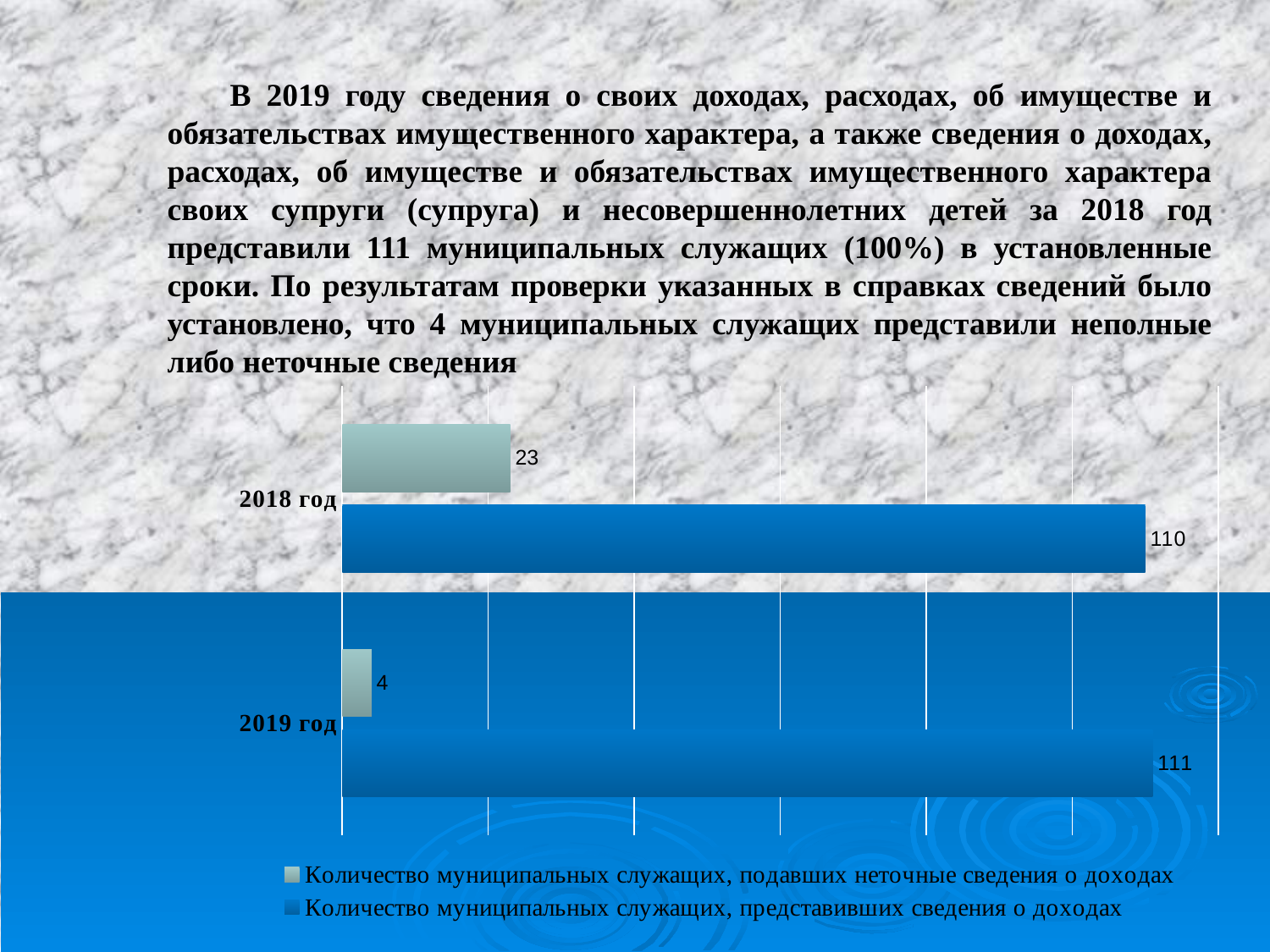
What is the value for 'Количество муниципальных служащих, подавших неточные сведения о доходах' in 2019 год? 4 How many categories (years) does the chart show? 2 Which series is shown in dark blue in the legend? Количество муниципальных служащих, представивших сведения о доходах What is the value for 'Количество муниципальных служащих, представивших сведения о доходах' in 2018 год? 110 Which year has the higher value for 'Количество муниципальных служащих, подавших неточные сведения о доходах'? 2018 год Which year has the lower value for 'Количество муниципальных служащих, представивших сведения о доходах'? 2018 год What is the difference between the 2018 and 2019 values for 'Количество муниципальных служащих, подавших неточные сведения о доходах'? 19 What is the value for 'Количество муниципальных служащих, подавших неточные сведения о доходах' in 2018 год? 23 How many series does the legend list? 2 What is the value for 'Количество муниципальных служащих, представивших сведения о доходах' in 2019 год? 111 What kind of chart is shown on the slide? bar chart Is the value for 'Количество муниципальных служащих, подавших неточные сведения о доходах' larger in 2018 год or in 2019 год? 2018 год